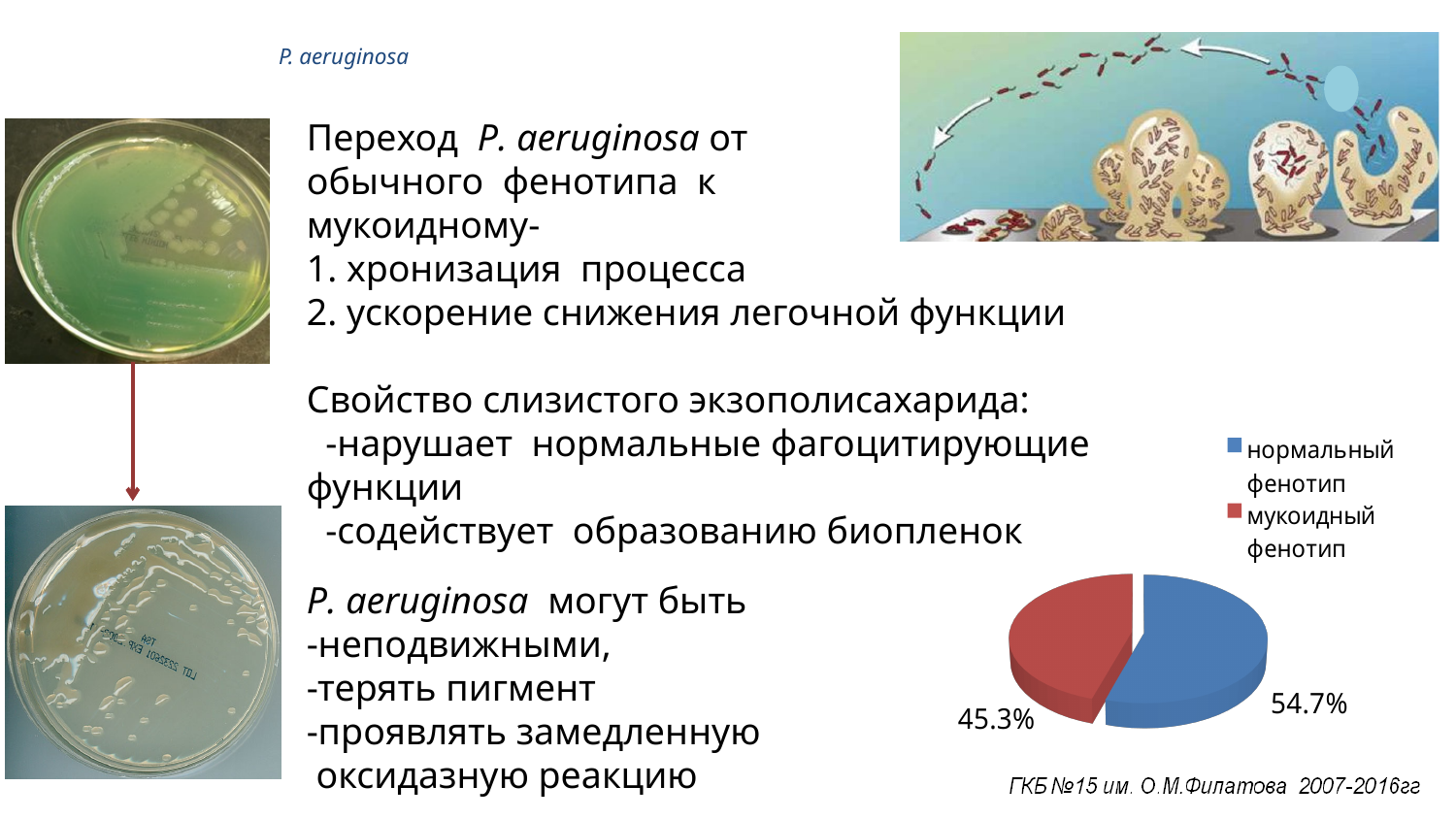
Is the share for the mucoid phenotype greater or less than 50%? less What colour is the slice for the mucoid phenotype (мукоидный фенотип) in the pie chart? red Which phenotype has the smaller slice in the pie chart? мукоидный фенотип What share of the pie chart is labelled for the mucoid phenotype (мукоидный фенотип)? 45.3% Is the slice for the normal phenotype larger or smaller than the slice for the mucoid phenotype? larger How many entries does the pie chart legend list? 2 What kind of chart is shown on the slide? pie chart What colour is the slice for the normal phenotype (нормальный фенотип) in the pie chart? blue What is the difference in percentage points between the normal phenotype slice and the mucoid phenotype slice? 9.4 Which phenotype has the larger slice in the pie chart? нормальный фенотип How many slices does the pie chart have? 2 What share of the pie chart is labelled for the normal phenotype (нормальный фенотип)? 54.7%